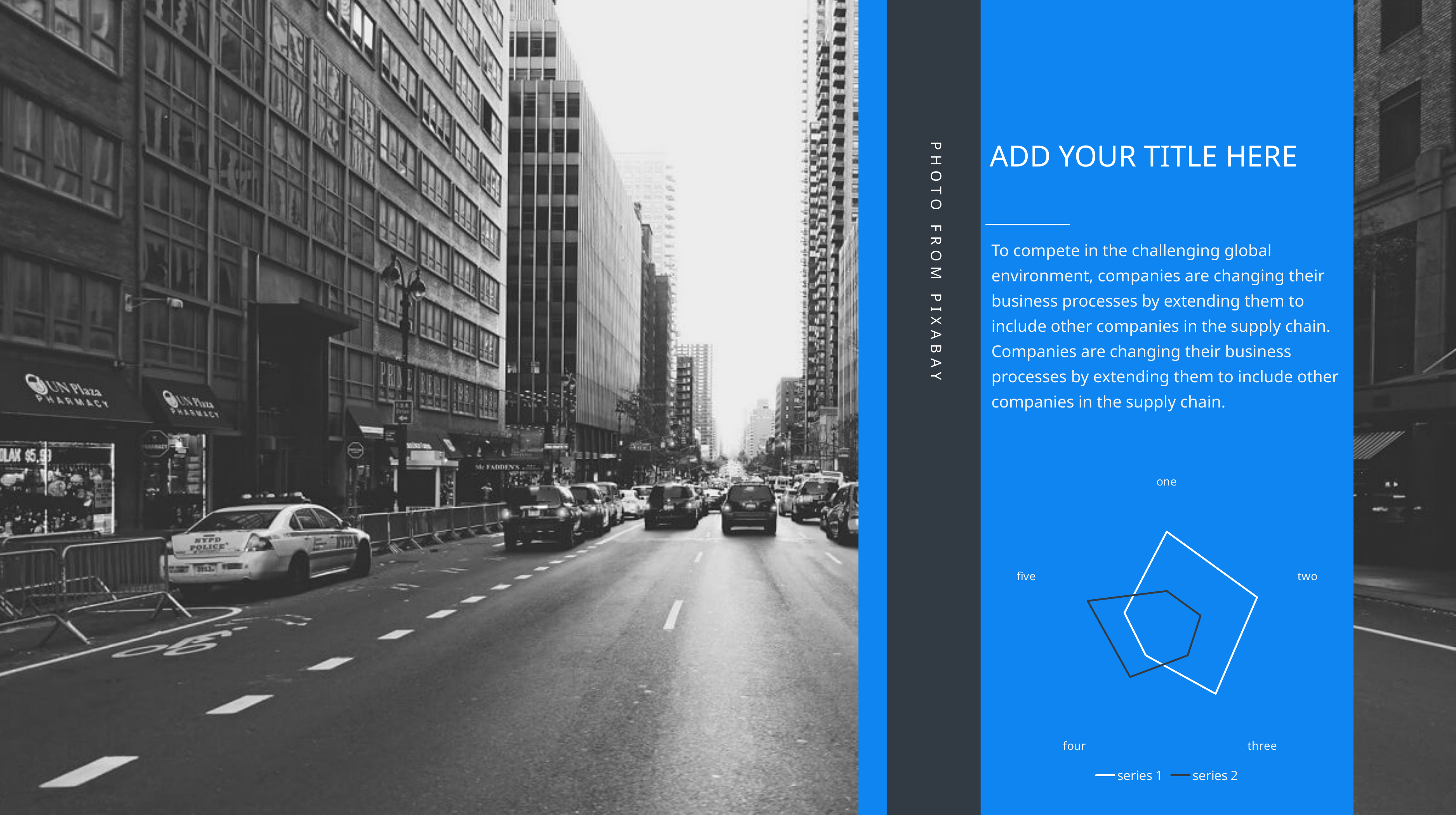
What are the category labels around the radar chart? one, two, three, four, five What are the names of the series in the radar chart's legend? series 1, series 2 For the category "five", which series has the larger value, series 1 or series 2? series 2 For the category "one", which series has the larger value, series 1 or series 2? series 1 For the category "three", which series has the larger value, series 1 or series 2? series 1 How many categories (axes) does the radar chart have? 5 What kind of chart is shown on the slide? radar chart How many series does the legend of the radar chart list? 2